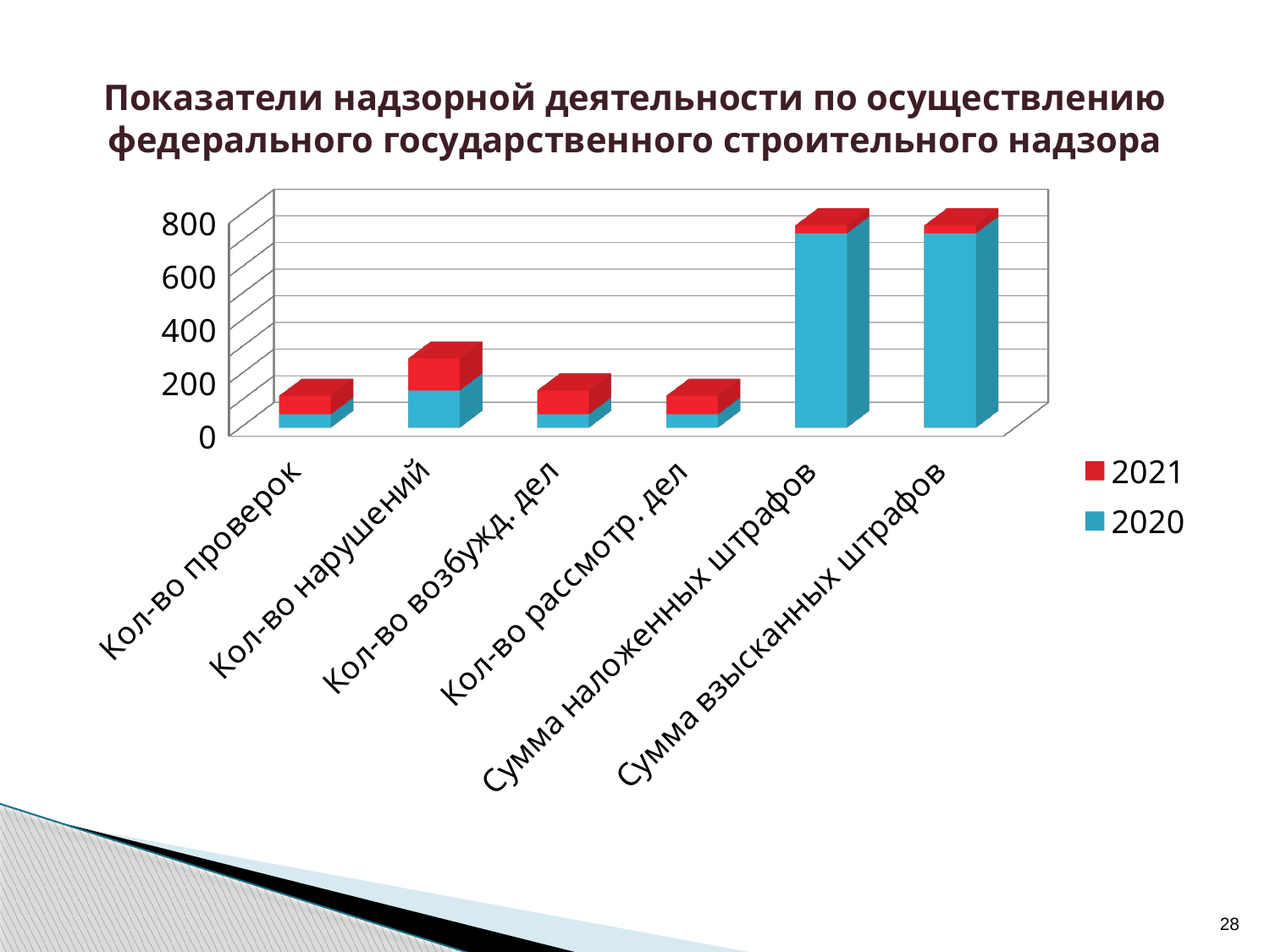
How many series does the chart legend list? 2 Is the total value for 'Кол-во нарушений' greater or less than 400? less Is the total value for 'Кол-во нарушений' greater or less than 200? greater Which has the larger total value: 'Сумма наложенных штрафов' or 'Кол-во рассмотр. дел'? Сумма наложенных штрафов Which has the larger total value: 'Кол-во нарушений' or 'Кол-во проверок'? Кол-во нарушений Is the total value for 'Кол-во проверок' greater or less than 200? less How many categories are shown on the x axis of the chart? 6 Which years are listed in the chart legend? 2021 and 2020 Which colour represents the 2020 series in the chart? Blue What kind of chart is shown on the slide? Stacked bar chart